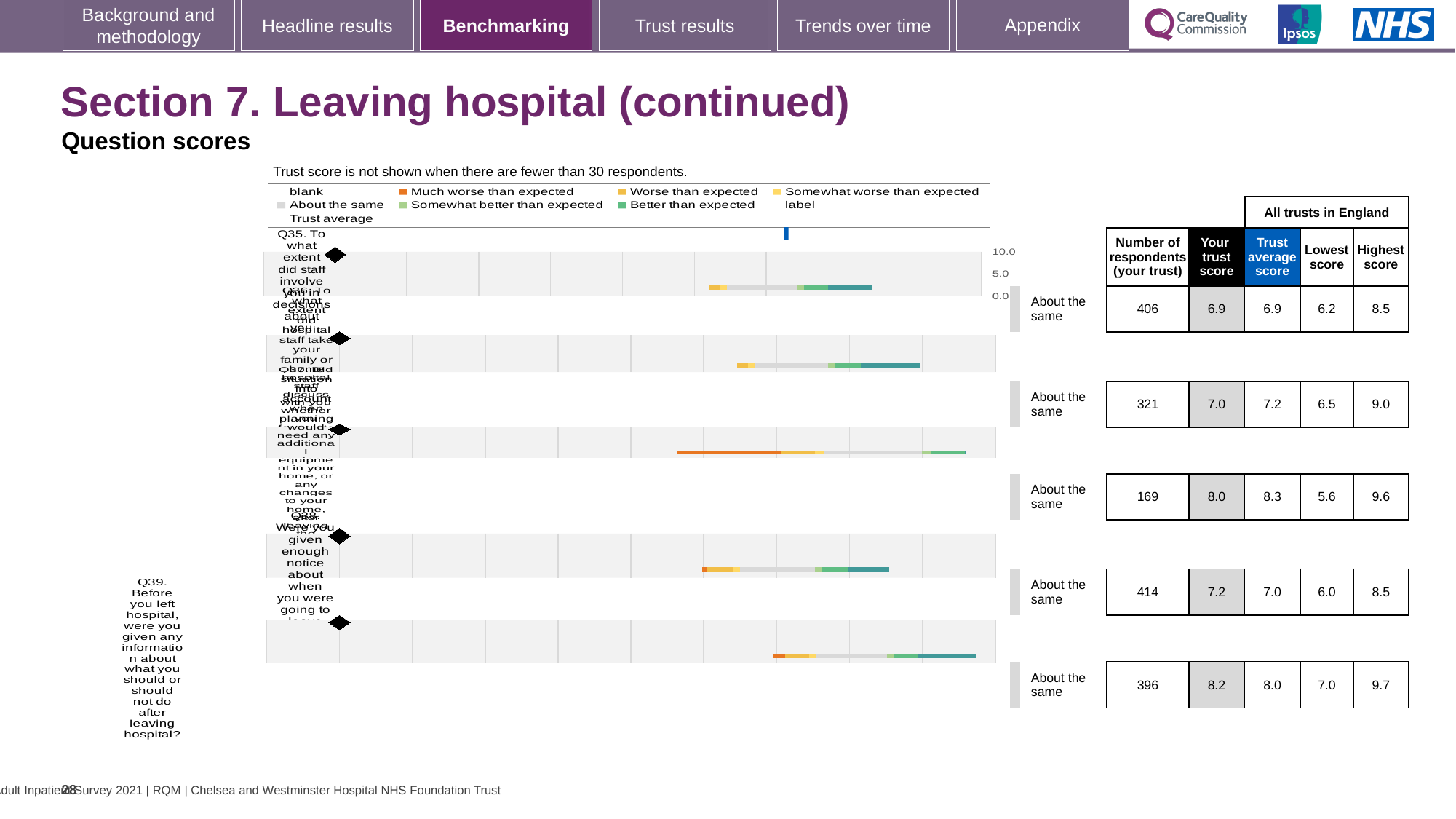
What is the trust average score for Q39, the last row of the table? 8.0 What is the difference between the highest score and the lowest score for Q37, the third row of the table? 4.0 What benchmark category is shown next to every question row in the chart? About the same How many question rows are shown in the benchmarking chart? 5 What kind of chart is used to show the question scores? Bar chart What is the highest score across all trusts in England for Q37, the third row of the table? 9.6 Which question row has the fewest respondents (your trust) in the table? Q37 (169) Which question row has the highest 'Your trust score' in the table? Q39 (8.2) What is the number of respondents (your trust) for Q35, the first row of the table? 406 For Q38, the fourth row of the table, which is larger: your trust score or the trust average score? Your trust score (7.2) What is the difference in number of respondents between Q38 (414) and Q39 (396)? 18 What is the lowest score across all trusts in England for Q38, the fourth row of the table? 6.0